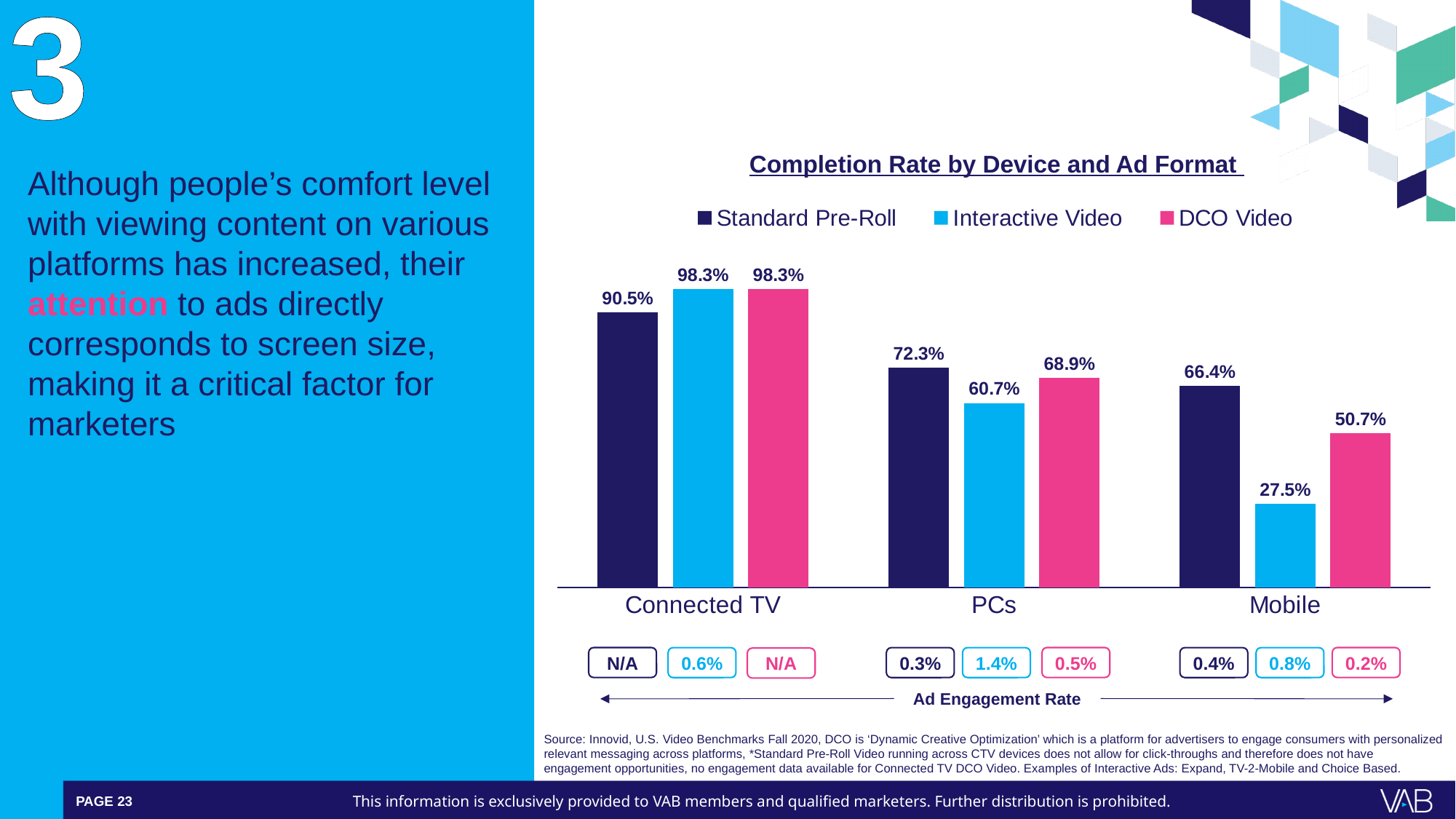
What is the completion rate for Interactive Video on Mobile? 27.5% Does the Standard Pre-Roll completion rate rise or fall from Connected TV to Mobile? Fall What is the completion rate for Standard Pre-Roll on Connected TV? 90.5% Which device has the lowest completion rate for Interactive Video? Mobile What is the completion rate for DCO Video on PCs? 68.9% What is the title of the chart? Completion Rate by Device and Ad Format What is the difference between the Standard Pre-Roll and Interactive Video completion rates on PCs? 11.6% Which device has the highest completion rate for Standard Pre-Roll? Connected TV Which is larger on Mobile: the Standard Pre-Roll completion rate or the DCO Video completion rate? Standard Pre-Roll How many series does the legend list? 3 What kind of chart is shown on the slide? Bar chart How many device categories are shown on the x axis? 3